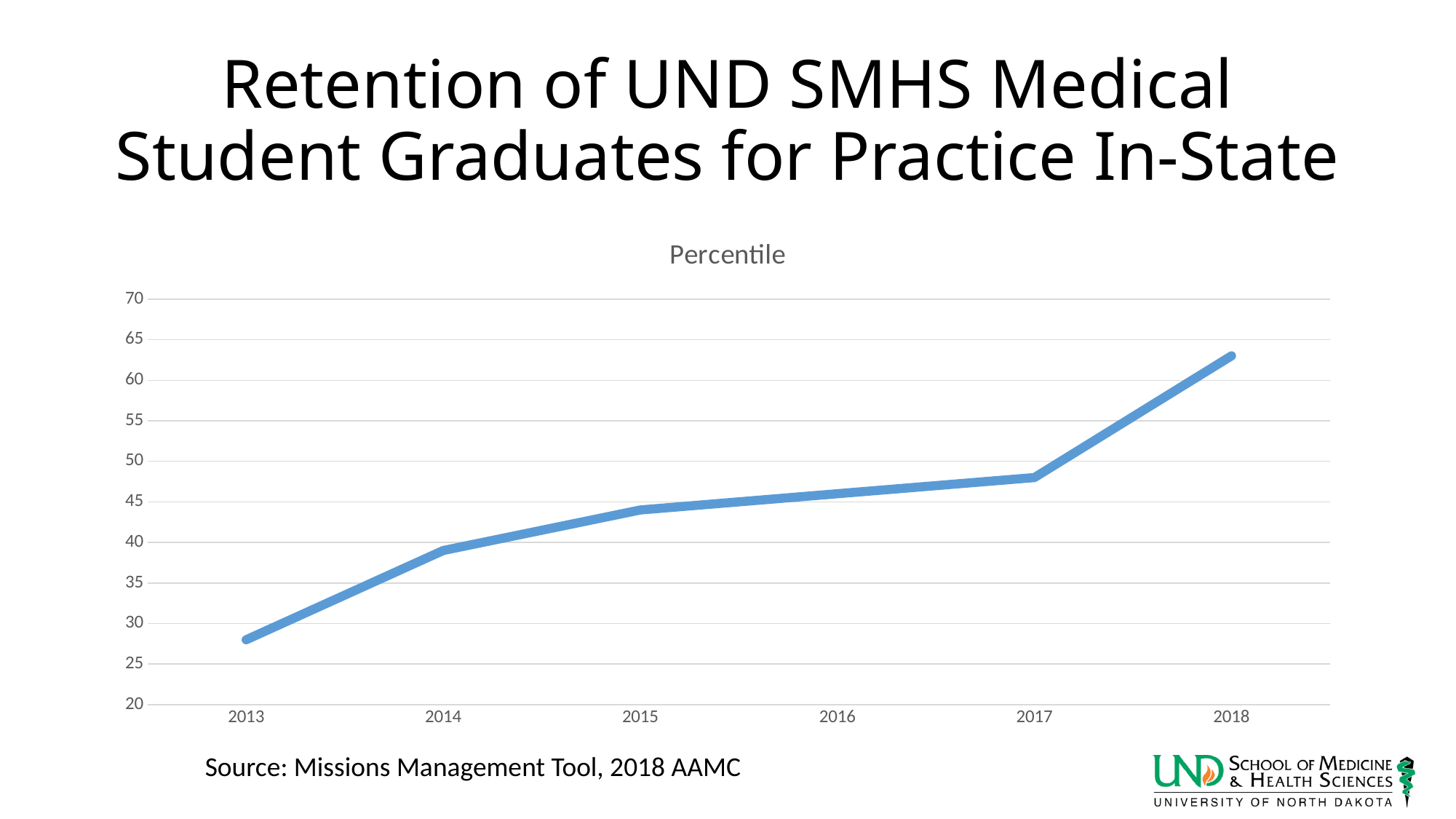
What is the title shown above the chart's plot area? Percentile How many years are plotted on the x axis of the chart? 6 Is the value for 2013 greater or less than 30? less Which year has the lowest value on the chart? 2013 Is the value for 2016 greater or less than 50? less Do the values rise or fall from 2013 to 2018? rise Is the value for 2014 greater or less than 35? greater Which year has the larger value, 2015 or 2014? 2015 Which year has the highest value on the chart? 2018 What kind of chart is shown on the slide? line chart